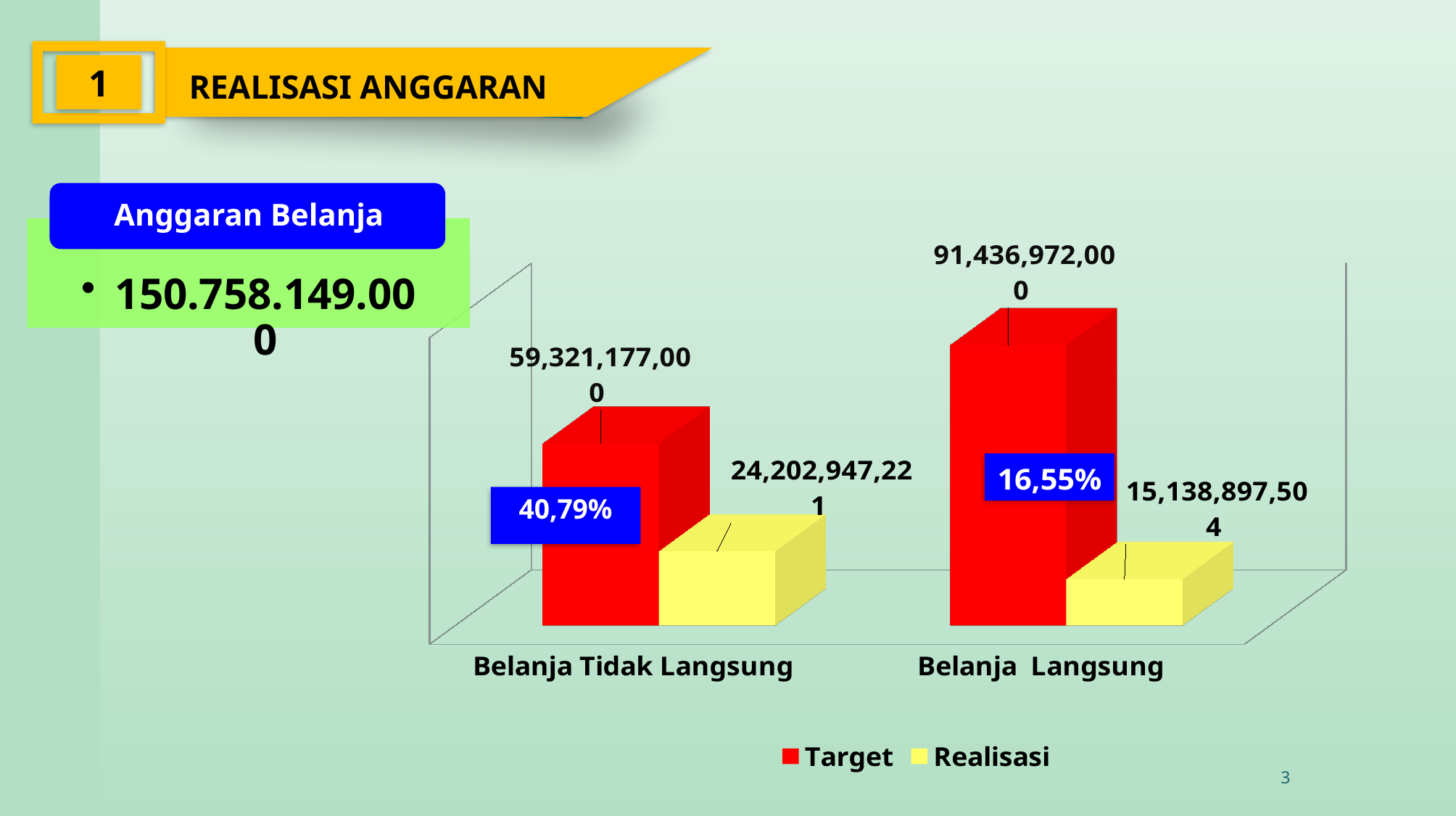
How many series does the chart legend list? 2 Which category has the highest Target value? Belanja Langsung Which category has the lowest Realisasi value? Belanja Langsung What is the Realisasi value for Belanja Tidak Langsung? 24,202,947,221 What is the Target value for Belanja Langsung? 91,436,972,000 What is the difference between the Target values for Belanja Langsung and Belanja Tidak Langsung? 32,115,795,000 Which is larger: the Realisasi value for Belanja Tidak Langsung or the Realisasi value for Belanja Langsung? Belanja Tidak Langsung What is the Realisasi value for Belanja Langsung? 15,138,897,504 What is the Target value for Belanja Tidak Langsung? 59,321,177,000 What is the difference between the Target and Realisasi values for Belanja Tidak Langsung? 35,118,229,779 How many categories are shown on the x axis of the chart? 2 What type of chart is shown on the slide? Bar chart